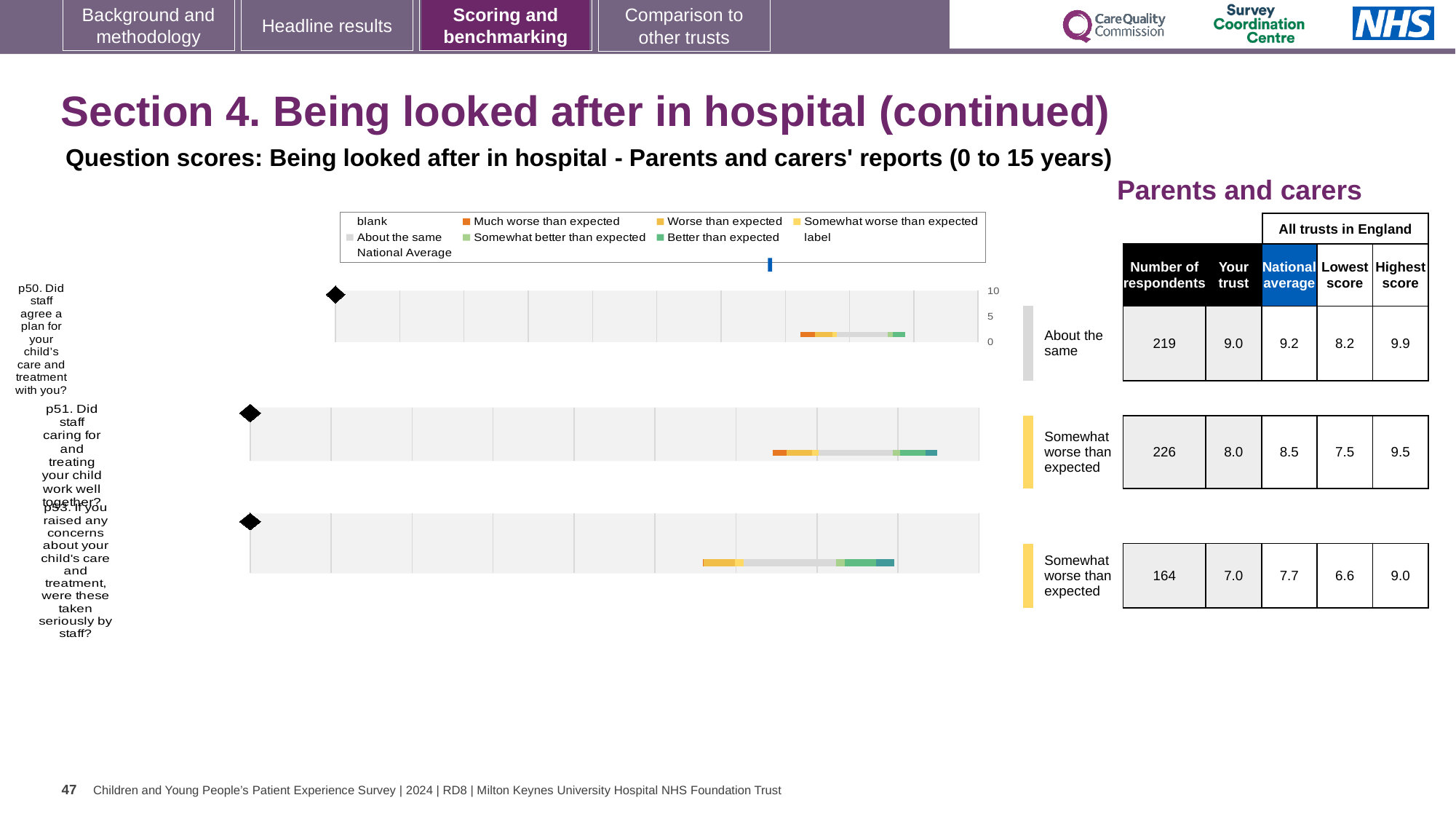
What is the difference between the national average and the 'Your trust' score for p53? 0.7 Which question has the highest 'Your trust' score on this slide? p50 What is the highest score across all trusts in England for p51? 9.5 How many survey questions are charted on this slide? 3 What is the national average score for p51 (Did staff caring for and treating your child work well together?)? 8.5 What is the lowest score across all trusts in England for p50? 8.2 What benchmark category is shown for p50 (Did staff agree a plan for your child's care and treatment with you?)? About the same How many respondents answered p53 (If you raised any concerns about your child's care and treatment, were these taken seriously by staff?)? 164 Which question has the lowest national average score on this slide? p53 Which has the higher 'Your trust' score, p51 or p53? p51 What kind of chart is used to show the question scores on this slide? Bar chart What is the 'Your trust' score for p50 (Did staff agree a plan for your child's care and treatment with you?)? 9.0